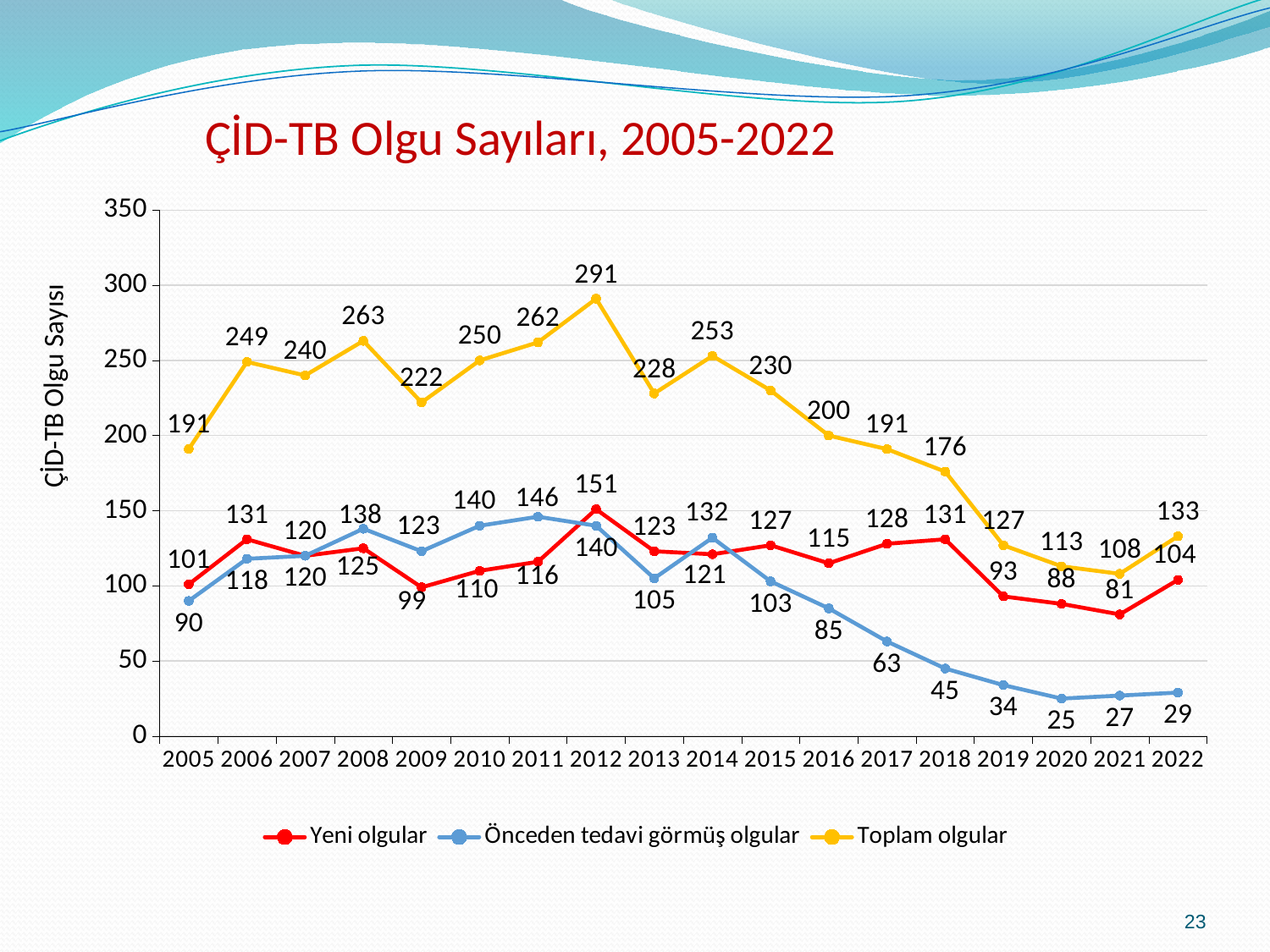
What is the value of Önceden tedavi görmüş olgular in 2020? 25 What is the title of the chart? ÇİD-TB Olgu Sayıları, 2005-2022 In which year is Toplam olgular highest? 2012 How many series does the legend list? 3 What kind of chart is shown on the slide? Line chart What is the value of Toplam olgular in 2012? 291 In which year is Önceden tedavi görmüş olgular lowest? 2020 Does Önceden tedavi görmüş olgular rise or fall from 2012 to 2020? Fall What is the value of Yeni olgular in 2021? 81 How many years are shown on the x axis? 18 What is the difference between Toplam olgular in 2012 and in 2021? 183 Which is larger in 2011: Yeni olgular or Önceden tedavi görmüş olgular? Önceden tedavi görmüş olgular